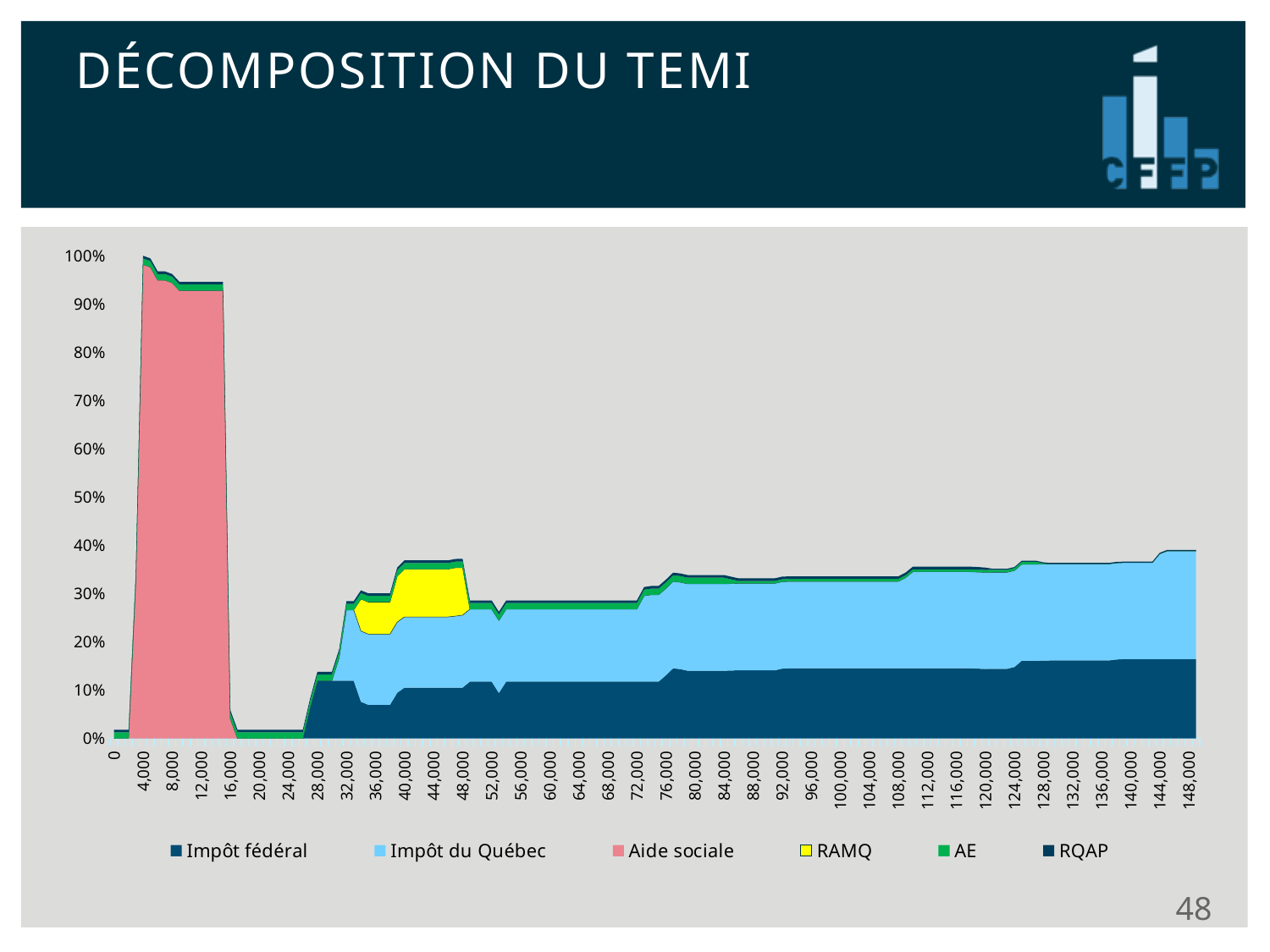
Is the total stacked value at 8,000 larger or smaller than the total at 148,000? larger How many series does the legend list? 6 Is the total stacked value at 44,000 greater or less than 30%? greater What is the title of the slide containing the chart? DÉCOMPOSITION DU TEMI Which series is shown in yellow in the chart? RAMQ What kind of chart is shown on the slide? Stacked area chart Is the total stacked value at 148,000 greater or less than 50%? less Is the total stacked value at 8,000 greater or less than 90%? greater Which series accounts for almost all of the stacked value at 8,000? Aide sociale Between 52,000 and 148,000, does the total stacked value generally rise or fall along the x axis? rise